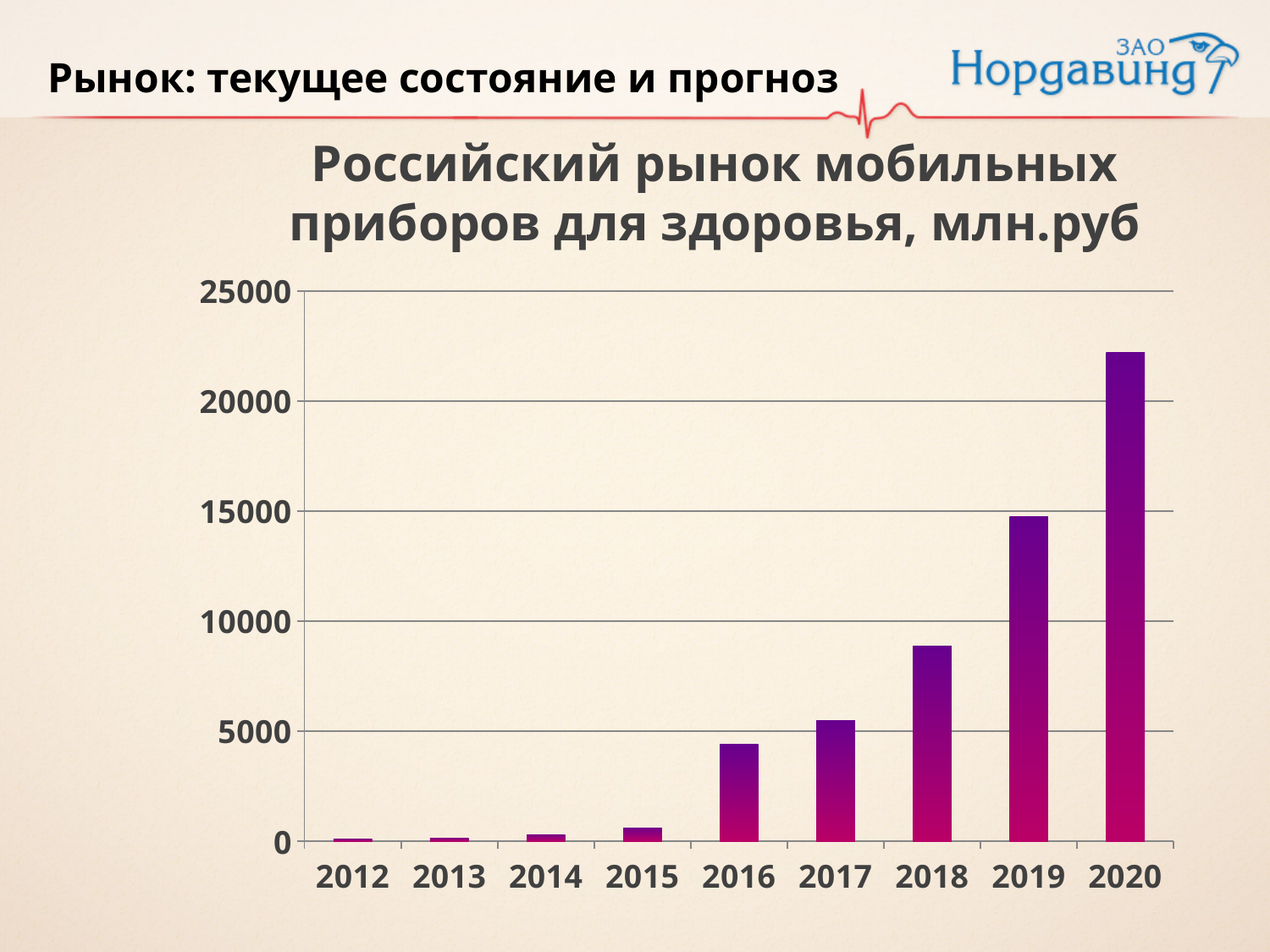
Is the value for 2016 greater or less than 5000? less Is the value for 2018 greater or less than 10000? less Which year has the highest value in the chart? 2020 What kind of chart is shown on the slide? bar chart Is the value for 2019 greater or less than 10000? greater What is the title of the chart? Российский рынок мобильных приборов для здоровья, млн.руб How many years are plotted on the x axis of the chart? 9 Which is larger, the value for 2018 or the value for 2017? 2018 Do the values rise or fall from 2012 to 2020? rise What is the highest tick value shown on the y axis of the chart? 25000